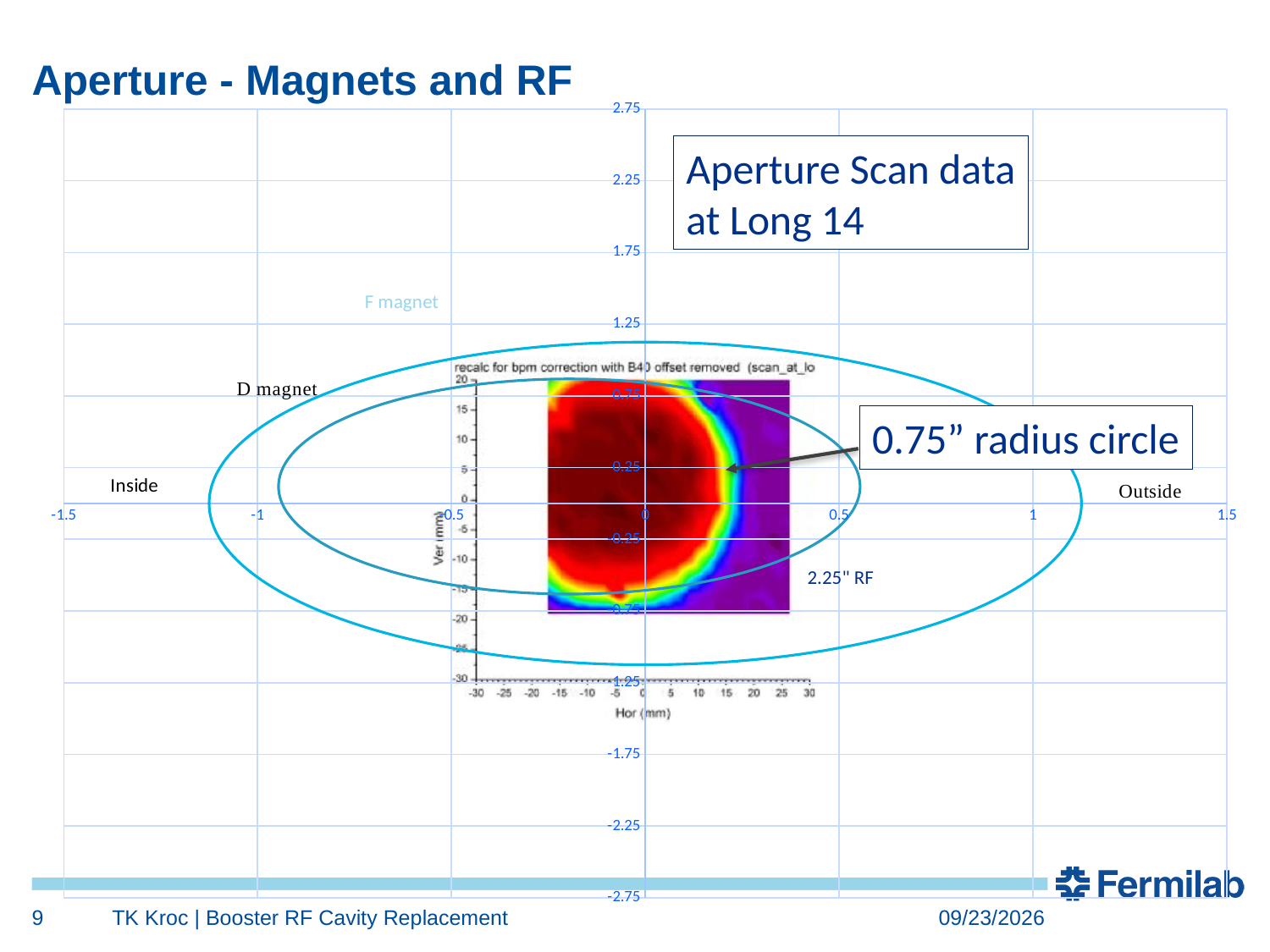
What radius does the callout give for the circle indicated by the arrow? 0.75" What kind of chart is shown on the slide? scatter chart What is the range of the horizontal axis of the chart? -1.5 to 1.5 What is the label of the RF aperture series on the chart? 2.25" RF What does the text box at the top of the chart say the plotted data is? Aperture Scan data at Long 14